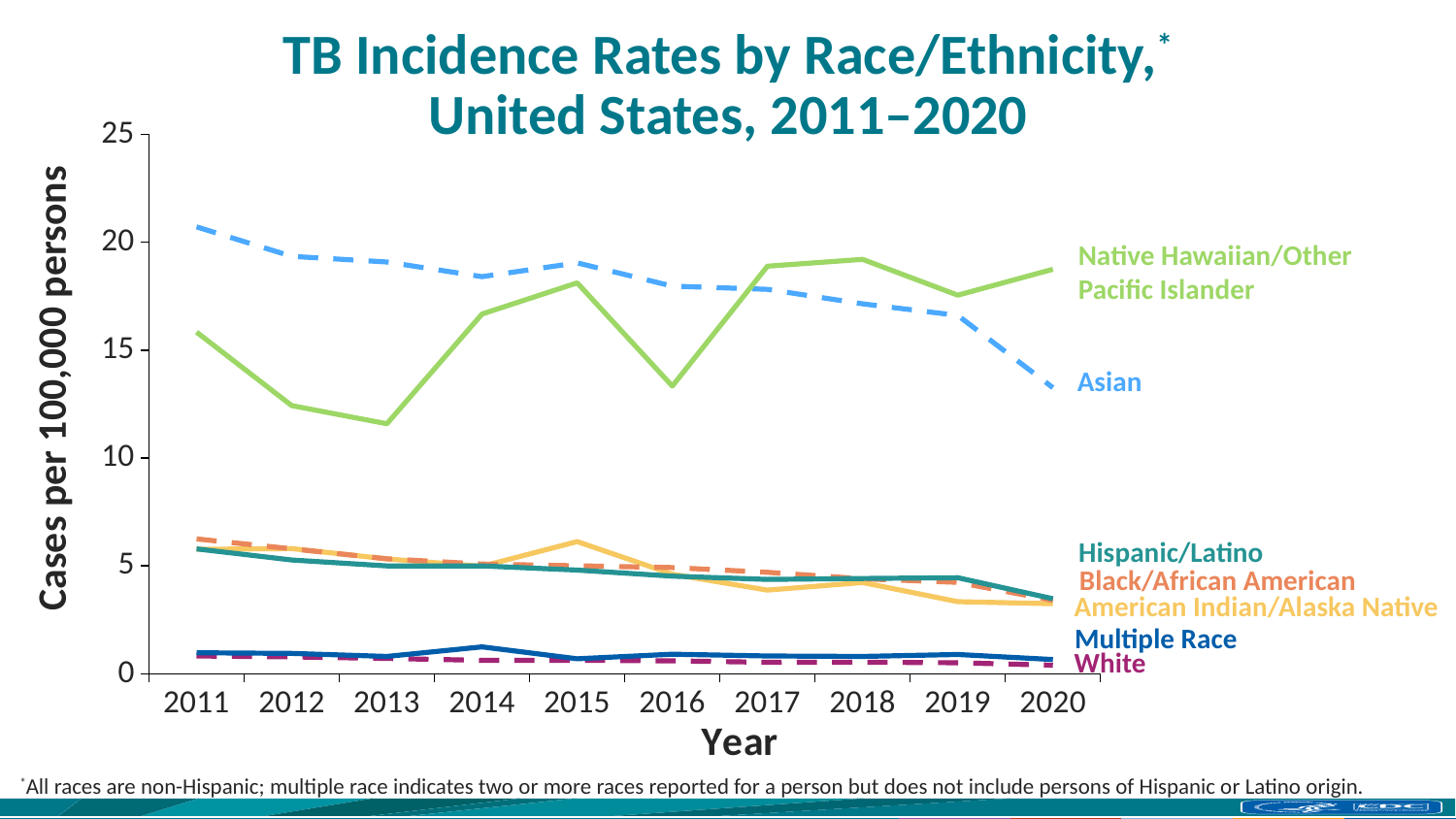
Is the TB incidence rate for Native Hawaiian/Other Pacific Islander persons in 2013 greater or less than 15? less Which race/ethnicity group has the highest TB incidence rate in 2011? Asian How many race/ethnicity series are plotted on the chart? 7 What is the label on the y axis of the chart? Cases per 100,000 persons What kind of chart is shown on the slide? line chart Which race/ethnicity group has the lowest TB incidence rate in 2020? White Is the TB incidence rate for Asian persons in 2011 greater or less than 20? greater In 2016, which group has the higher TB incidence rate: Asian or Native Hawaiian/Other Pacific Islander? Asian Which race/ethnicity group has the highest TB incidence rate in 2020? Native Hawaiian/Other Pacific Islander Is the TB incidence rate for Asian persons in 2020 greater or less than 15? less Does the TB incidence rate for Asian persons rise or fall from 2011 to 2020? fall How many years are shown along the x axis? 10